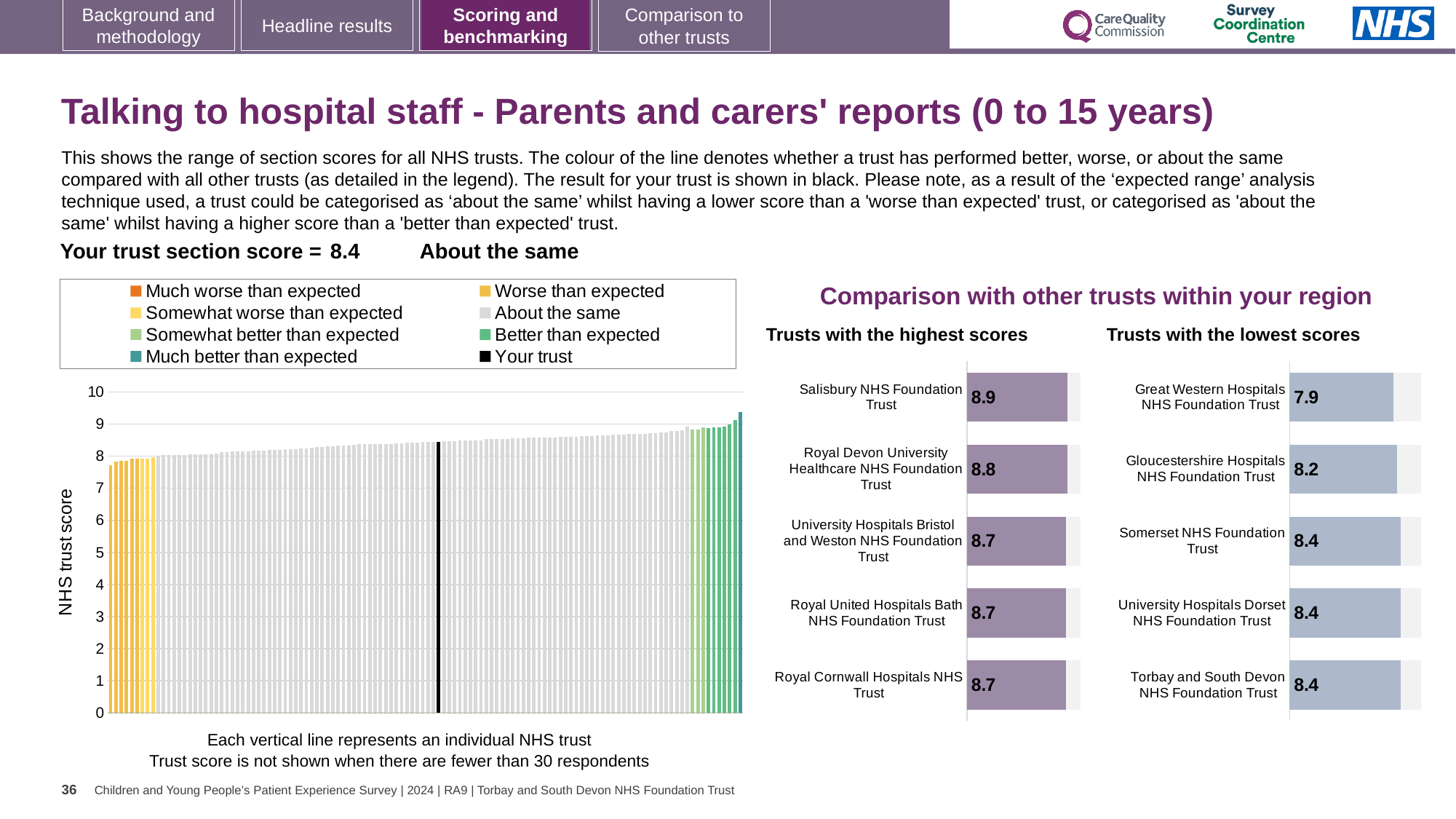
In the 'Trusts with the lowest scores' chart, what is the score for Gloucestershire Hospitals NHS Foundation Trust? 8.2 In the large chart on the left showing all NHS trusts, do the trust scores rise or fall from left to right along the x axis? Rise In the 'Trusts with the lowest scores' chart, what is the score for Great Western Hospitals NHS Foundation Trust? 7.9 In the 'Trusts with the highest scores' chart, which has the larger score: Salisbury NHS Foundation Trust or Royal Cornwall Hospitals NHS Trust? Salisbury NHS Foundation Trust In the large chart on the left showing all NHS trusts, how many entries does the legend list? 8 In the 'Trusts with the highest scores' chart, what is the score for Salisbury NHS Foundation Trust? 8.9 In the 'Trusts with the highest scores' chart, what is the score for Royal Devon University Healthcare NHS Foundation Trust? 8.8 In the 'Trusts with the lowest scores' chart, how many trusts are shown? 5 In the 'Trusts with the highest scores' chart, which trust has the highest score? Salisbury NHS Foundation Trust In the 'Trusts with the lowest scores' chart, what is the difference between the scores of Gloucestershire Hospitals NHS Foundation Trust and Great Western Hospitals NHS Foundation Trust? 0.3 What kind of chart is the large chart on the left showing the range of section scores for all NHS trusts? Bar chart In the 'Trusts with the lowest scores' chart, which trust has the lowest score? Great Western Hospitals NHS Foundation Trust